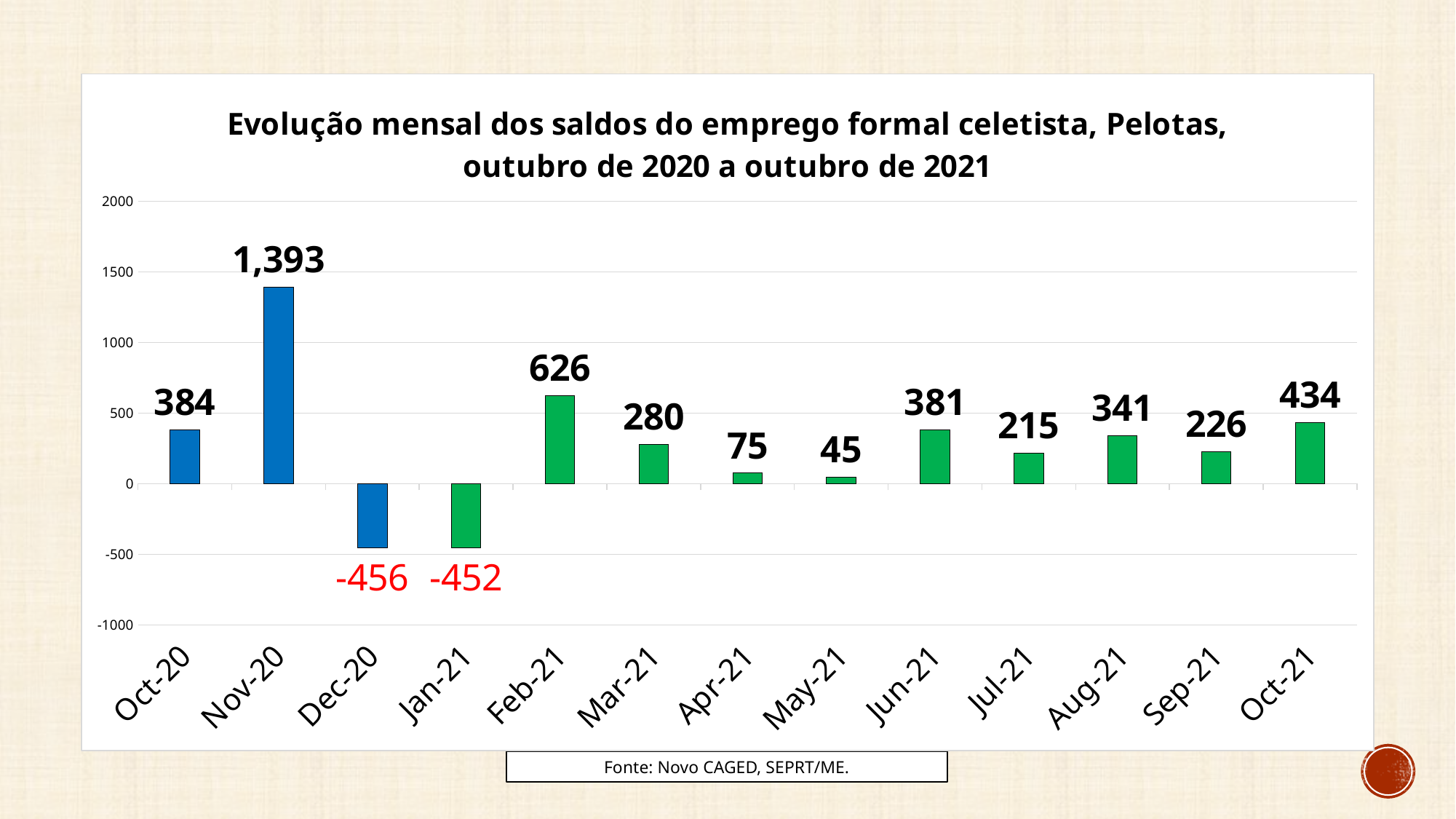
What is the value for Nov-20? 1,393 Is the value for Feb-21 greater or less than 500? greater What is the difference between the values for Nov-20 and Feb-21? 767 What source is cited below the chart? Novo CAGED, SEPRT/ME. What is the value for Oct-21? 434 Which month has the highest value? Nov-20 What is the value for Feb-21? 626 Which is larger, the value for Jun-21 or the value for Aug-21? Jun-21 What kind of chart is shown on the slide? bar chart Which month has the lowest value? Dec-20 What is the value for Dec-20? -456 How many months are shown on the x axis? 13